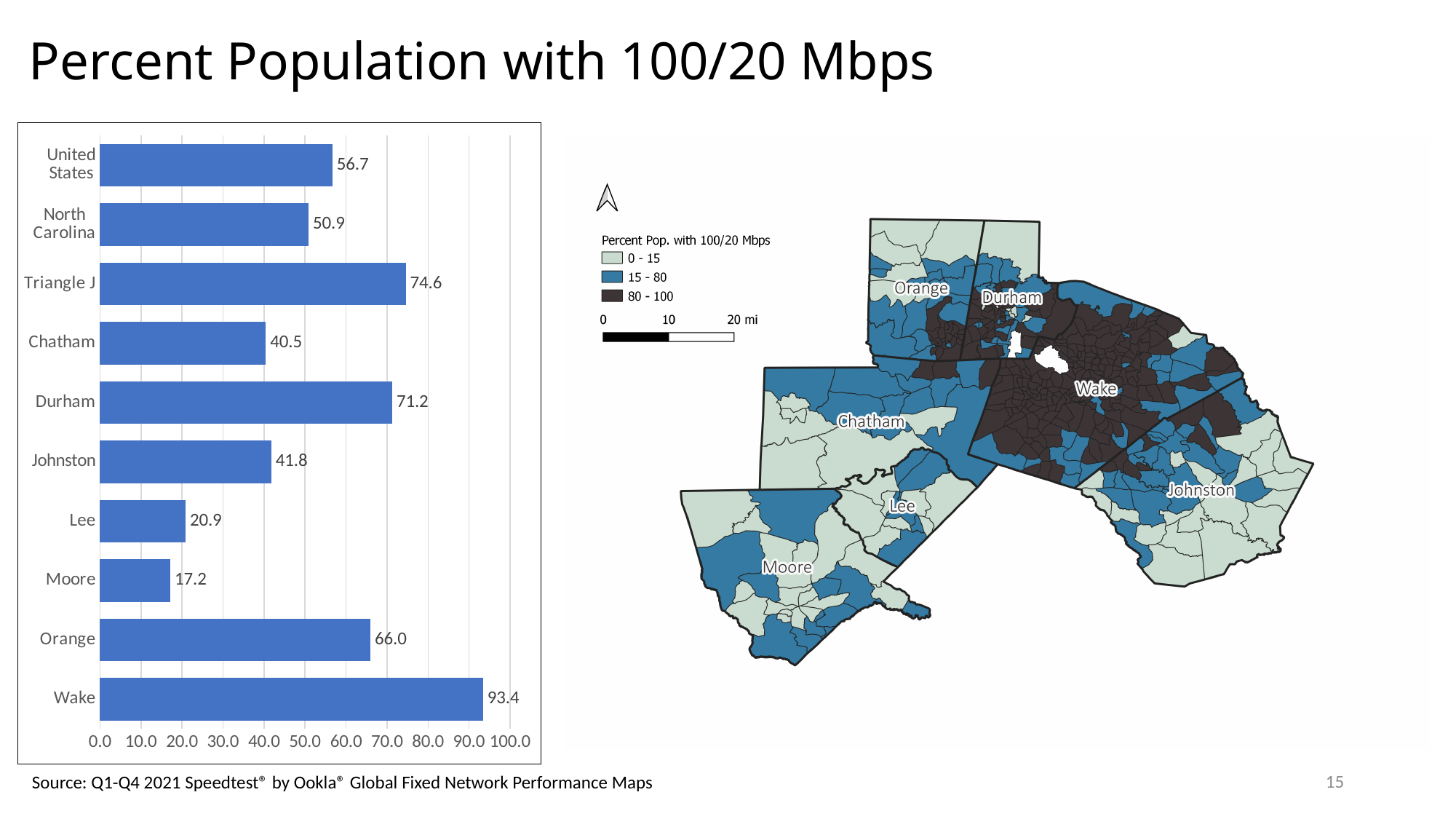
What is the difference between the values for Wake and Moore in the bar chart? 76.2 What is the difference between the values for Triangle J and North Carolina in the bar chart? 23.7 What is the value for Wake in the bar chart? 93.4 Is the value for Chatham in the bar chart greater or less than 50.0? less How many categories are shown in the bar chart? 10 What is the value for North Carolina in the bar chart? 50.9 How many ranges does the map legend list for Percent Pop. with 100/20 Mbps? 3 Which category has the highest value in the bar chart? Wake What is the value for Lee in the bar chart? 20.9 Which has a larger value in the bar chart, Durham or Orange? Durham What kind of chart is shown on the left of the slide? bar chart Which category has the lowest value in the bar chart? Moore